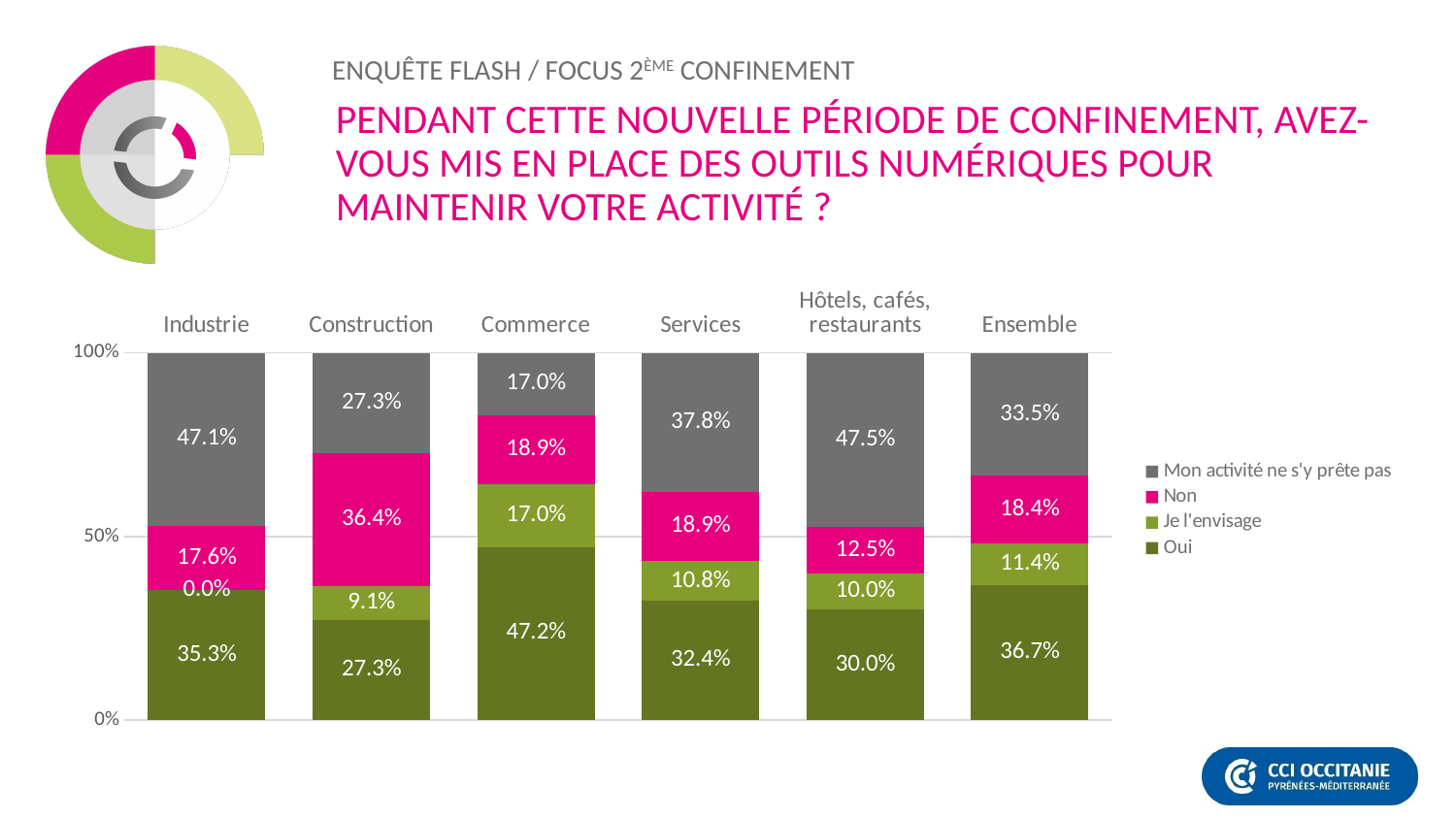
How many categories are shown on the x axis? 6 Which category has the lowest 'Je l'envisage' value? Industrie What is the 'Je l'envisage' value for Ensemble? 11.4% What is the difference between the 'Oui' values for Commerce and Construction? 19.9% What is the 'Non' value for Construction? 36.4% What kind of chart is shown on the slide? Stacked bar chart What is the 'Mon activité ne s'y prête pas' value for Hôtels, cafés, restaurants? 47.5% What is the 'Oui' value for Commerce? 47.2% How many series does the legend list? 4 Which is larger: the 'Non' value for Industrie or the 'Non' value for Hôtels, cafés, restaurants? Industrie Which legend entry is shown in pink? Non Which category has the highest 'Oui' value? Commerce